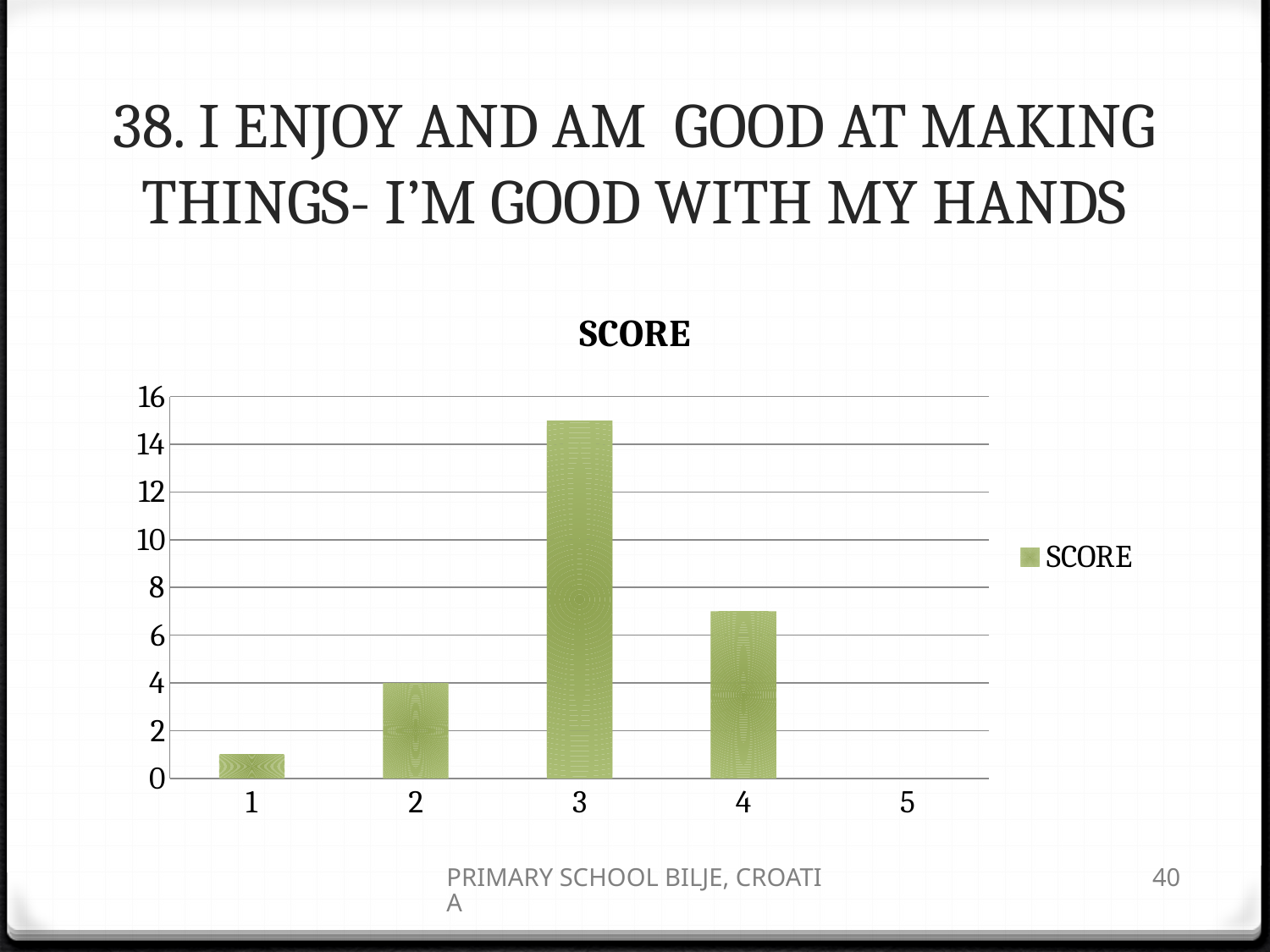
What is the value for category 2? 4 What is the title of the chart? SCORE How many categories are shown on the x axis? 5 Which has the larger value, category 4 or category 2? 4 Which category has no visible bar? 5 What is the name of the series shown in the legend? SCORE What type of chart is shown on the slide? bar chart Is the value for category 3 greater or less than 14? greater Which category has the tallest bar? 3 How many series does the legend list? 1 Is the value for category 1 greater or less than 2? less Is the value for category 4 greater or less than 8? less